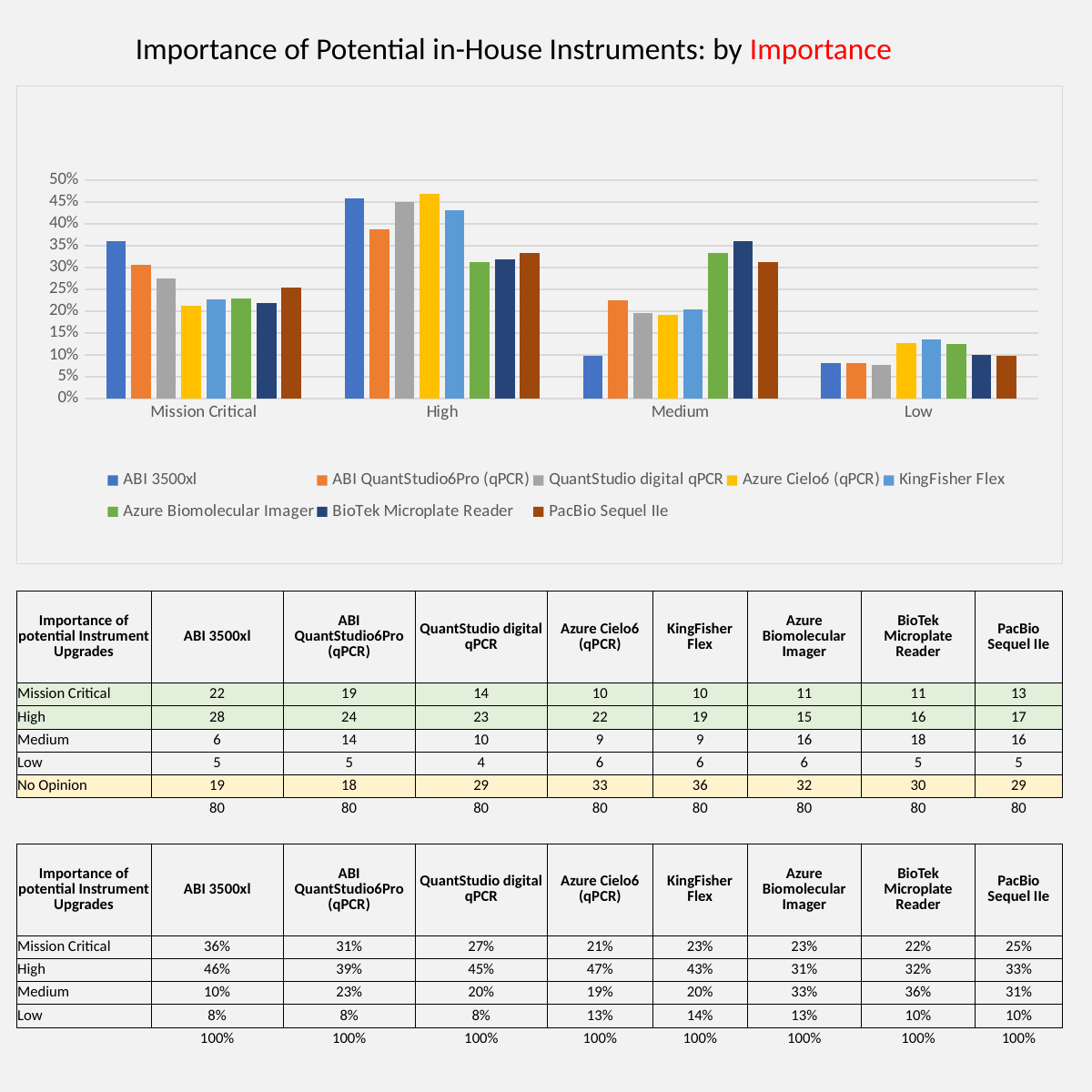
Is the value for KingFisher Flex in the Low category greater or less than 10%? greater What is the value for ABI 3500xl in the Mission Critical category? 36% In the Mission Critical category, which instrument has the highest bar? ABI 3500xl How many importance categories are shown along the x axis of the chart? 4 How many series does the chart's legend list? 8 What kind of chart is shown on the slide? bar chart In the Mission Critical category, which is larger: ABI 3500xl or ABI QuantStudio6Pro (qPCR)? ABI 3500xl Does the value for ABI 3500xl rise or fall from the High category to the Low category? fall What is the title of the slide containing the chart? Importance of Potential in-House Instruments: by Importance What is the difference between ABI 3500xl and Azure Cielo6 (qPCR) in the Mission Critical category? 15% Is the value for ABI 3500xl in the High category greater or less than 40%? greater In the Medium category, which instrument has the highest bar? BioTek Microplate Reader